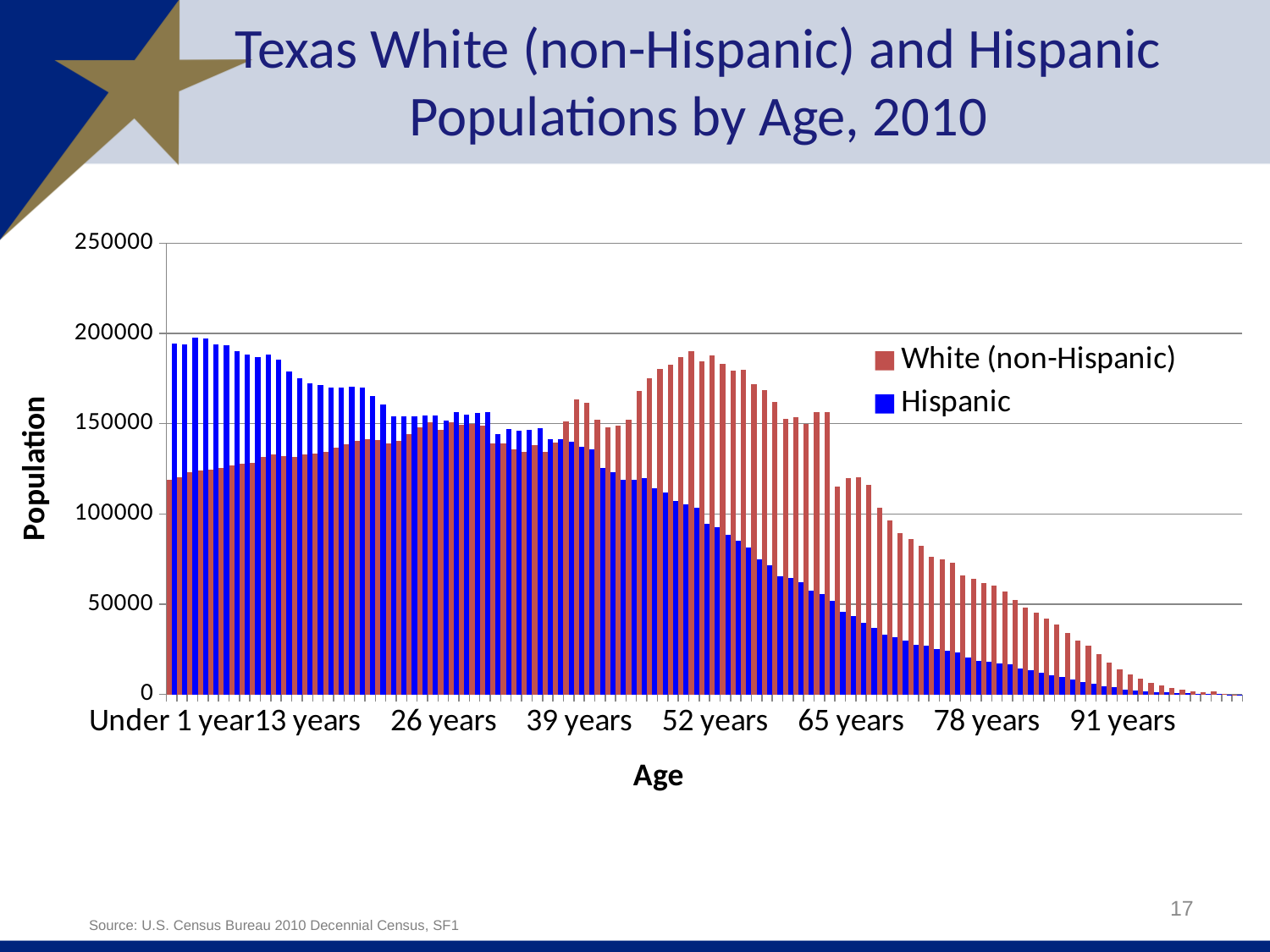
Is the White (non-Hispanic) value for 52 years greater or less than 150000? greater Is the Hispanic value for 78 years greater or less than 50000? less What is the label of the vertical axis? Population At Under 1 year, which series has the larger value, White (non-Hispanic) or Hispanic? Hispanic Is the White (non-Hispanic) value for Under 1 year greater or less than 150000? less How many series does the legend list? 2 What is the title of the chart? Texas White (non-Hispanic) and Hispanic Populations by Age, 2010 Do the Hispanic values generally rise or fall from Under 1 year to 91 years? fall What kind of chart is shown on the slide? bar chart At 52 years, which series has the larger value, White (non-Hispanic) or Hispanic? White (non-Hispanic)